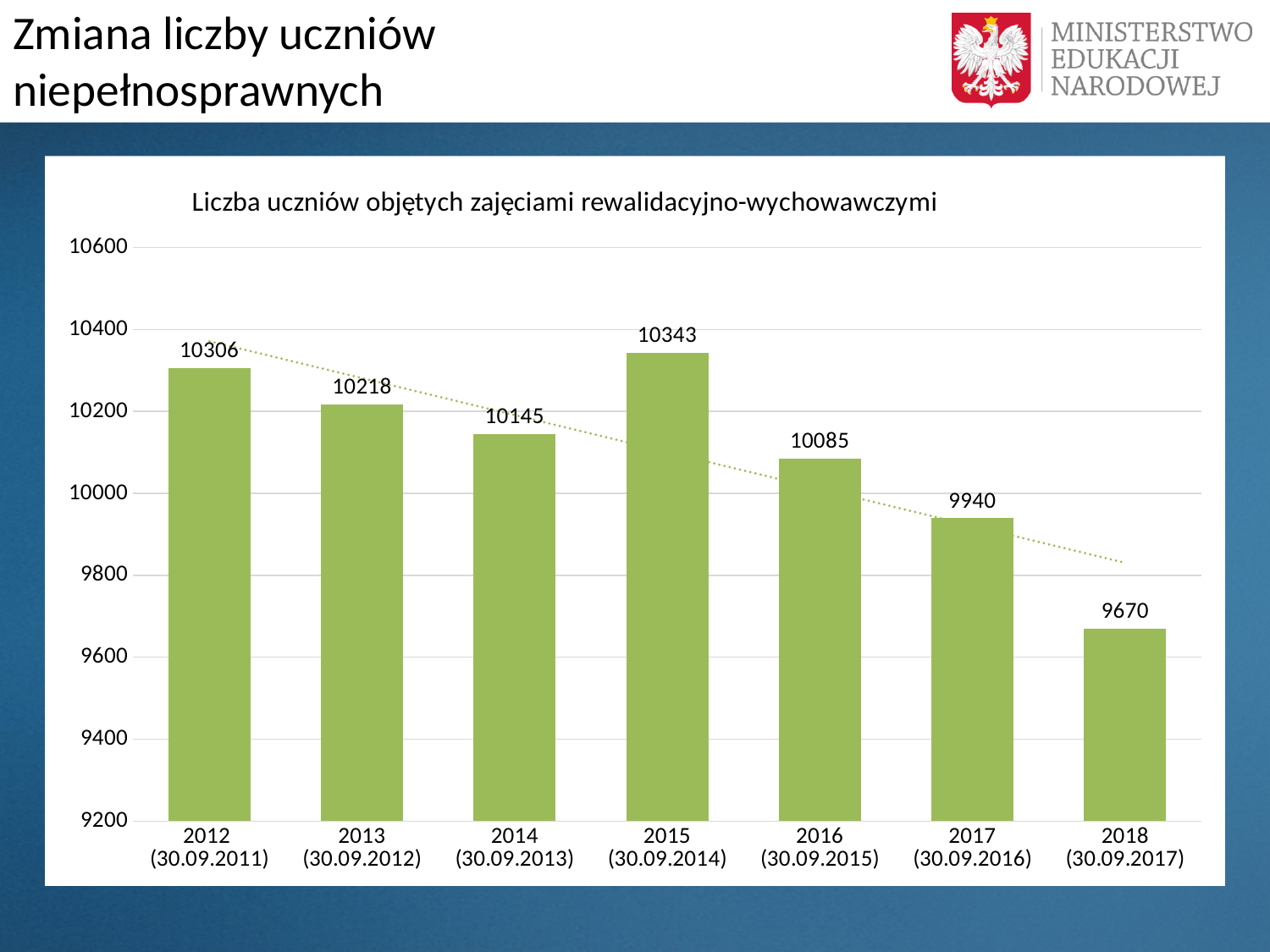
Which year has the highest value? 2015 (30.09.2014) Which year has the lowest value? 2018 (30.09.2017) What is the title of the chart? Liczba uczniów objętych zajęciami rewalidacyjno-wychowawczymi What is the value for 2018 (30.09.2017)? 9670 What is the value for 2015 (30.09.2014)? 10343 What kind of chart is this? bar chart Is the value for 2017 (30.09.2016) greater or less than 10000? less What is the difference between the values for 2012 (30.09.2011) and 2018 (30.09.2017)? 636 How many years are shown on the x axis? 7 What is the difference between the values for 2016 (30.09.2015) and 2017 (30.09.2016)? 145 What is the value for 2013 (30.09.2012)? 10218 Which is larger, the value for 2014 (30.09.2013) or the value for 2016 (30.09.2015)? 2014 (30.09.2013)